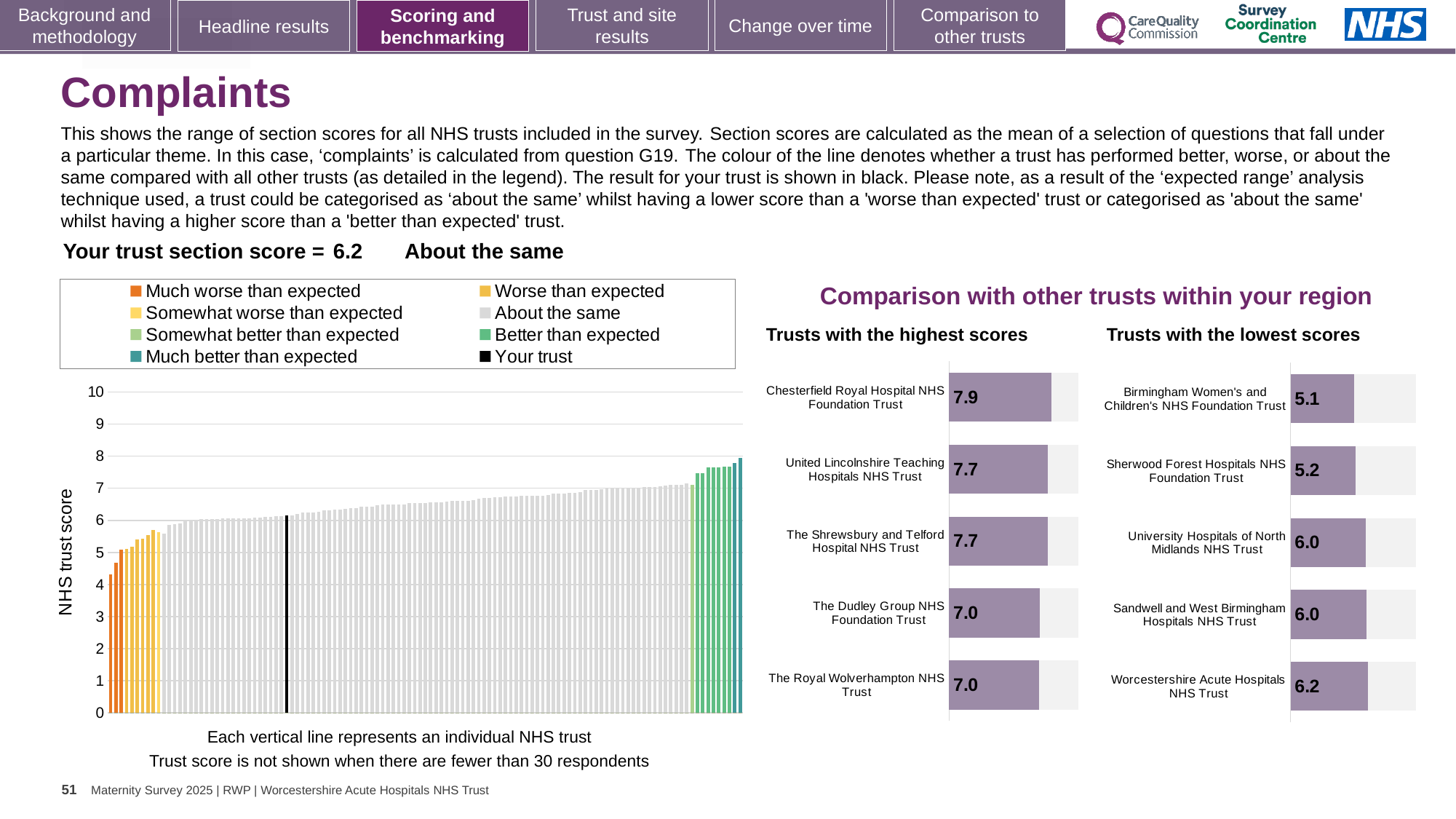
In the 'Trusts with the highest scores' chart, which trust has the highest score? Chesterfield Royal Hospital NHS Foundation Trust In the 'NHS trust score' chart on the left, is the value of the lowest bar greater or less than 5? less In the 'Trusts with the highest scores' chart, what is the difference between the scores of Chesterfield Royal Hospital NHS Foundation Trust and The Dudley Group NHS Foundation Trust? 0.9 In the 'Trusts with the lowest scores' chart, which trust has the lowest score? Birmingham Women's and Children's NHS Foundation Trust What kind of chart is the 'NHS trust score' chart on the left of the slide? Bar chart In the 'Trusts with the lowest scores' chart, what is the difference between the scores of Worcestershire Acute Hospitals NHS Trust and Birmingham Women's and Children's NHS Foundation Trust? 1.1 In the 'Trusts with the highest scores' chart, what is the score for Chesterfield Royal Hospital NHS Foundation Trust? 7.9 In the 'Trusts with the lowest scores' chart, which has the larger score: Sherwood Forest Hospitals NHS Foundation Trust or Worcestershire Acute Hospitals NHS Trust? Worcestershire Acute Hospitals NHS Trust In the 'NHS trust score' chart on the left, do the bar values rise or fall from left to right? Rise How many entries does the legend above the 'NHS trust score' chart list? 8 In the 'Trusts with the highest scores' chart, how many trusts are listed? 5 In the 'Trusts with the lowest scores' chart, what is the score for Sherwood Forest Hospitals NHS Foundation Trust? 5.2